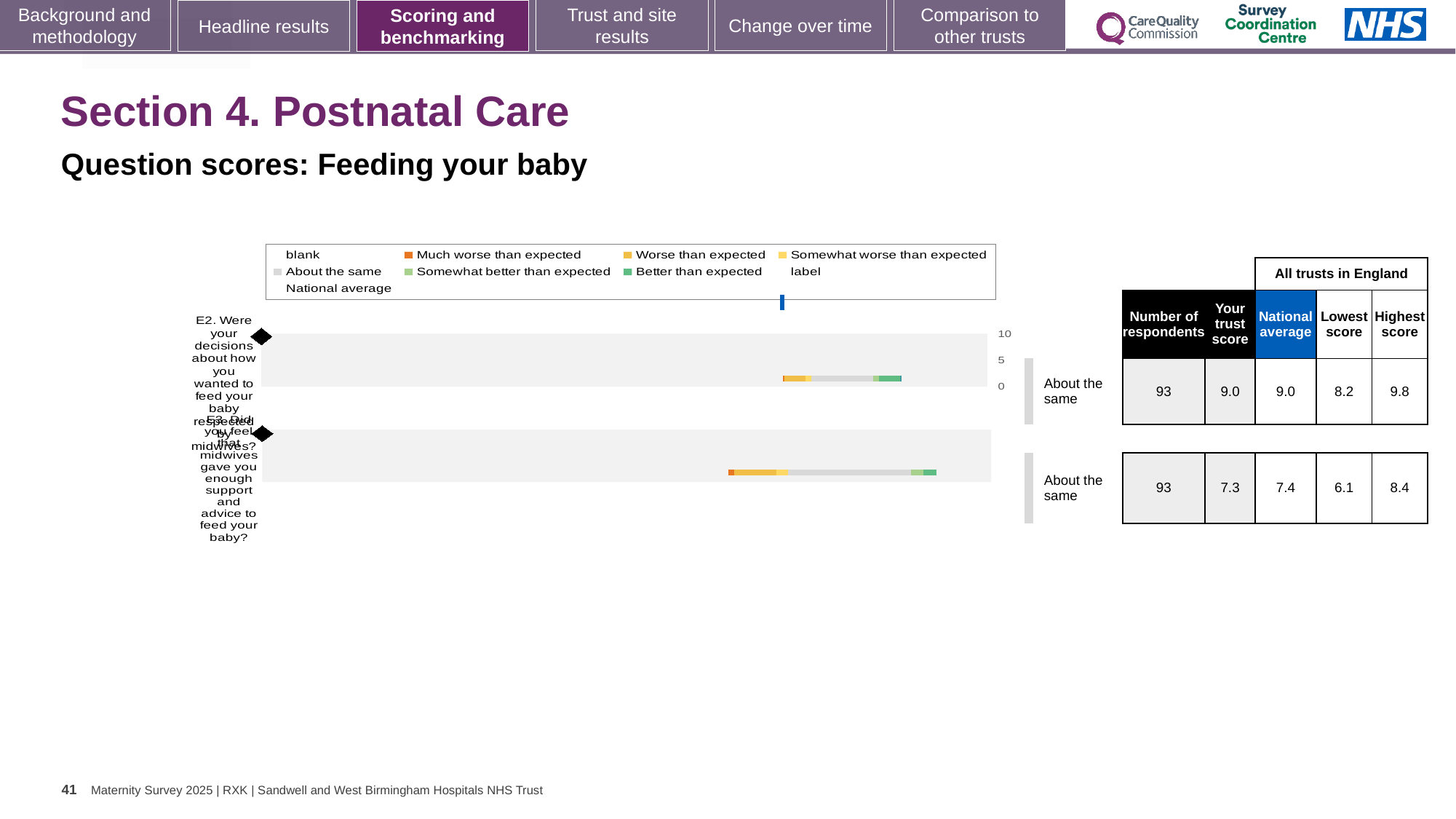
What is the national average for question E3? 7.4 What is the difference between the highest and lowest scores for question E3 across all trusts in England? 2.3 What kind of chart is used to show the question scores for Feeding your baby? bar chart What is the trust score for question E2 about decisions on how you wanted to feed your baby? 9.0 What is the lowest score among all trusts in England for question E3? 6.1 Which question has the higher trust score, E2 or E3? E2 How many questions (categories) are plotted in the Feeding your baby chart? 2 Which legend entry is shown in dark orange in the Feeding your baby chart? Much worse than expected What is the highest score among all trusts in England for question E2? 9.8 How many respondents answered question E2? 93 What is the difference between the trust score and the national average for question E3? 0.1 What is the trust score for question E3 about midwives giving enough support and advice to feed your baby? 7.3